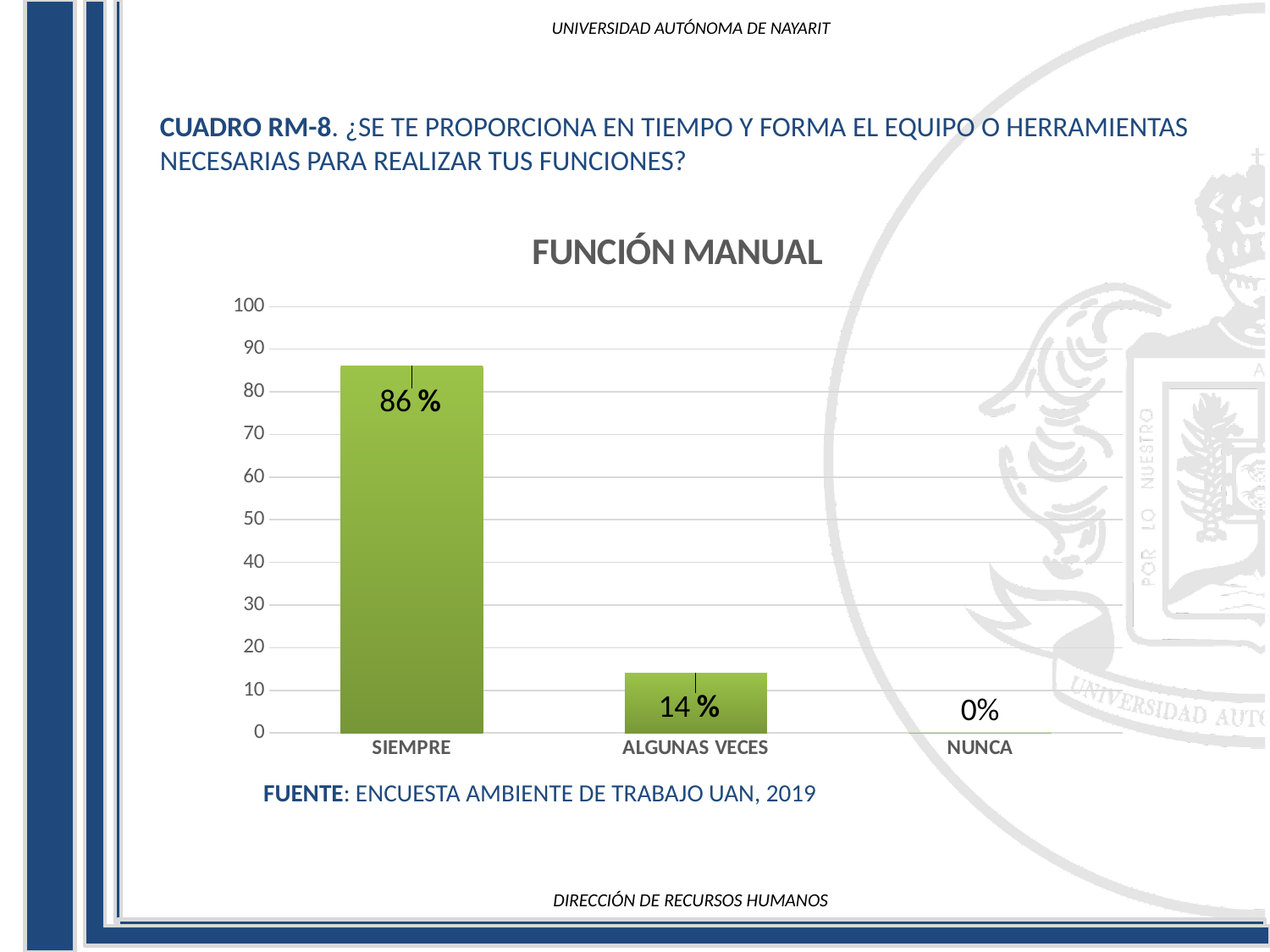
What kind of chart is shown on the slide? bar chart What is the title of the chart? FUNCIÓN MANUAL Which is larger, the value for ALGUNAS VECES or the value for NUNCA? ALGUNAS VECES Which category has the highest value? SIEMPRE What is the difference between the values for SIEMPRE and ALGUNAS VECES? 72 % Which category has the lowest value? NUNCA How many categories are shown on the x axis? 3 Is the value for ALGUNAS VECES greater or less than 20? less What is the value for ALGUNAS VECES? 14 % What is the value for SIEMPRE? 86 % Is the value for SIEMPRE greater or less than 80? greater What is the value for NUNCA? 0%